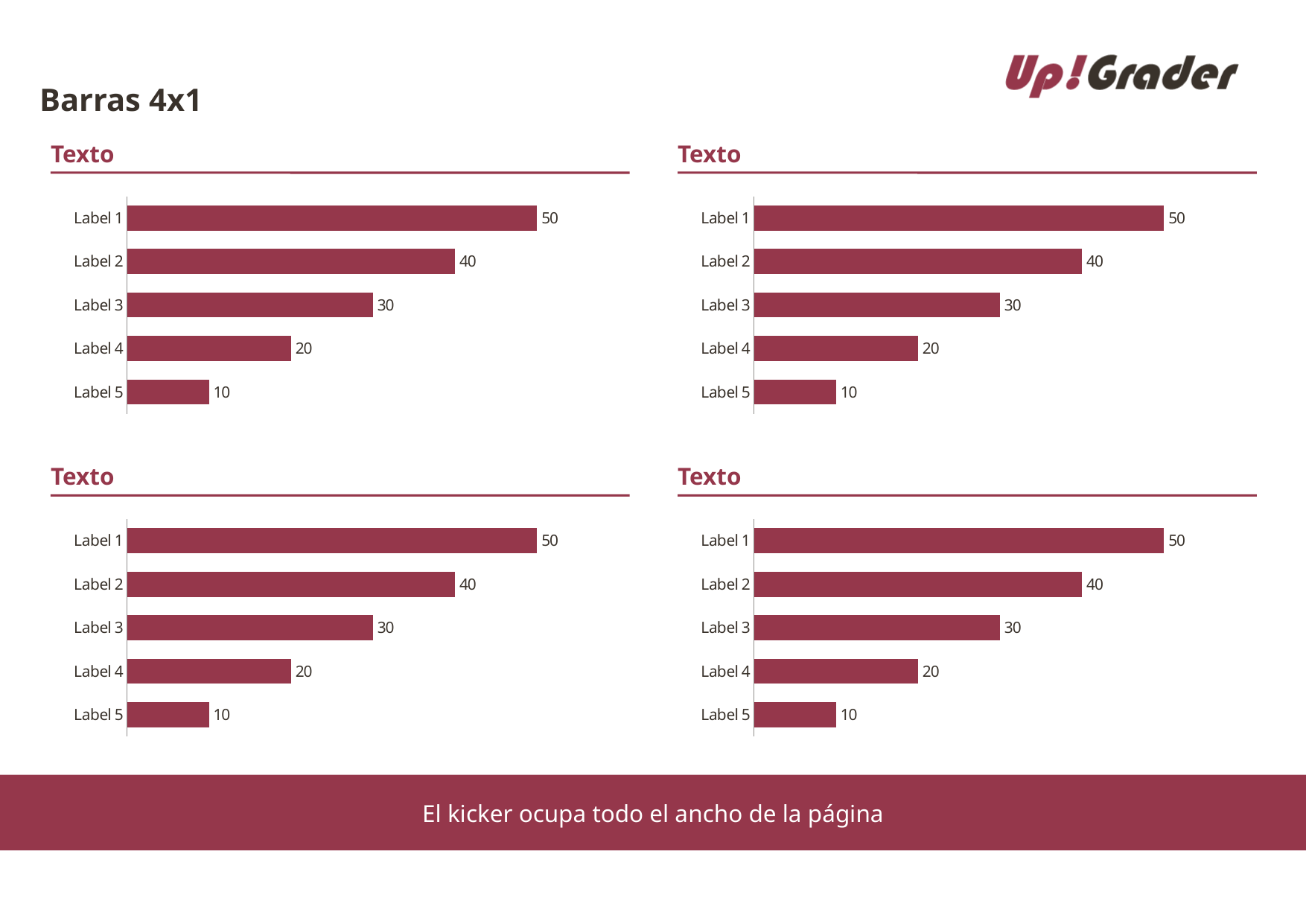
In the bottom-left chart, what is the value for Label 5? 10 In the top-left chart, which is larger, the value for Label 3 or the value for Label 4? Label 3 In the top-right chart, what is the difference between the values for Label 1 and Label 2? 10 How many categories does the bottom-right chart show? 5 In the top-right chart, what is the value for Label 3? 30 In the bottom-right chart, which category has the lowest value? Label 5 In the top-left chart, which category has the highest value? Label 1 In the bottom-left chart, what is the difference between the values for Label 2 and Label 5? 30 What kind of chart is the top-left chart? Bar chart In the top-left chart, what is the value for Label 1? 50 How many charts are on the slide? 4 In the bottom-right chart, what is the value for Label 4? 20